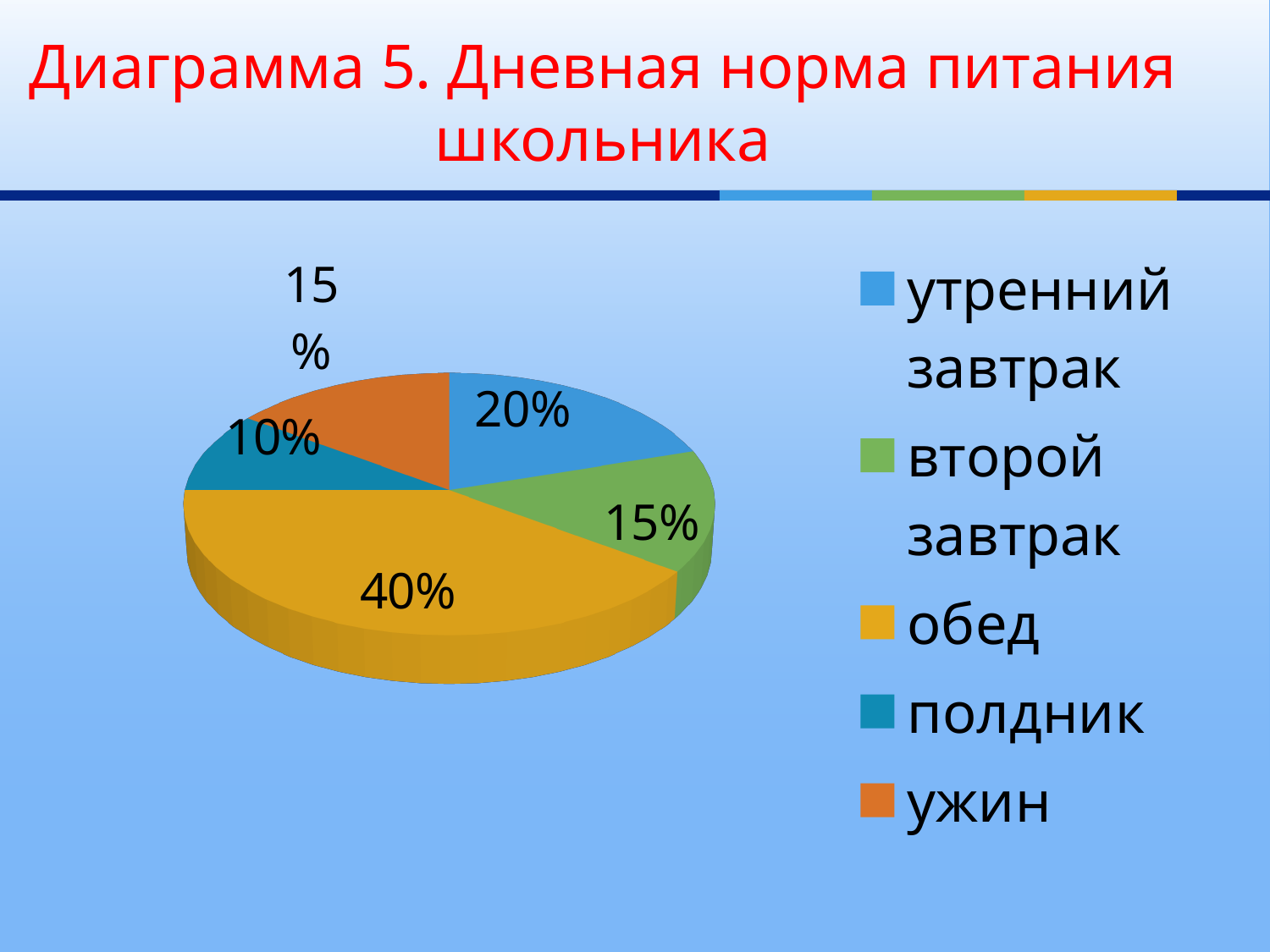
What is the difference between the shares of обед and утренний завтрак? 20% Which category has the largest share of the pie? обед What is the value for полдник? 10% How many categories does the legend list? 5 What is the value for утренний завтрак? 20% What is the value for ужин? 15% What is the value for второй завтрак? 15% What colour is the slice for обед? yellow What share of the pie does обед take? 40% Which is larger, the share for утренний завтрак or the share for полдник? утренний завтрак Which category has the smallest share of the pie? полдник What kind of chart is shown on the slide? pie chart